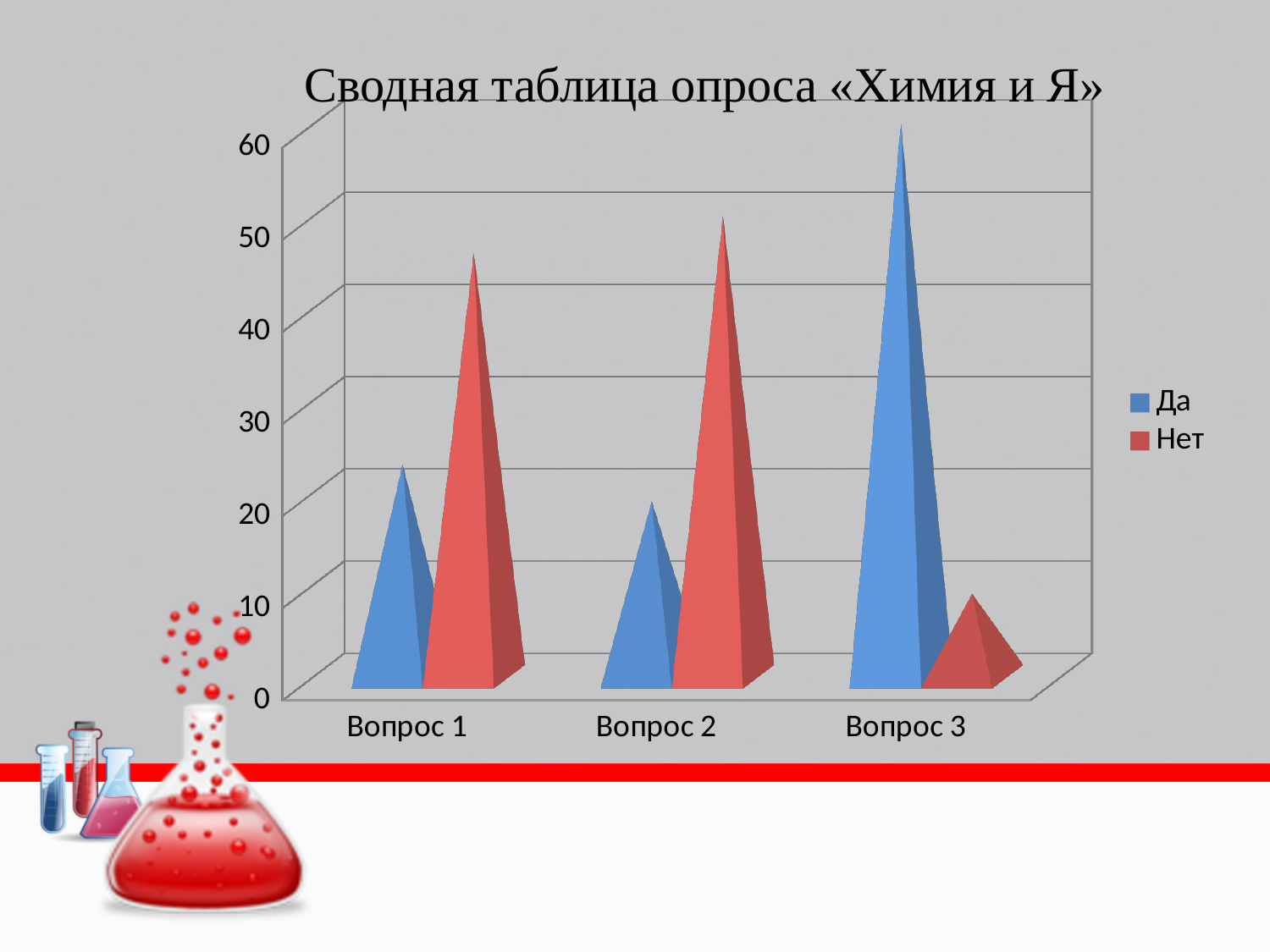
How many series does the legend list? 2 What are the two series named in the legend? Да and Нет What kind of chart is shown on the slide? bar chart Is the Да value for Вопрос 3 greater or less than 50? greater Is the Нет value for Вопрос 3 greater or less than 20? less For which question is the Да value highest? Вопрос 3 How many categories are shown on the x axis of the chart? 3 What is the title of the chart? Сводная таблица опроса «Химия и Я» Is the Нет value for Вопрос 1 greater or less than 40? greater For Вопрос 1, which is larger, Да or Нет? Нет For Вопрос 3, which is larger, Да or Нет? Да For which question is the Нет value lowest? Вопрос 3